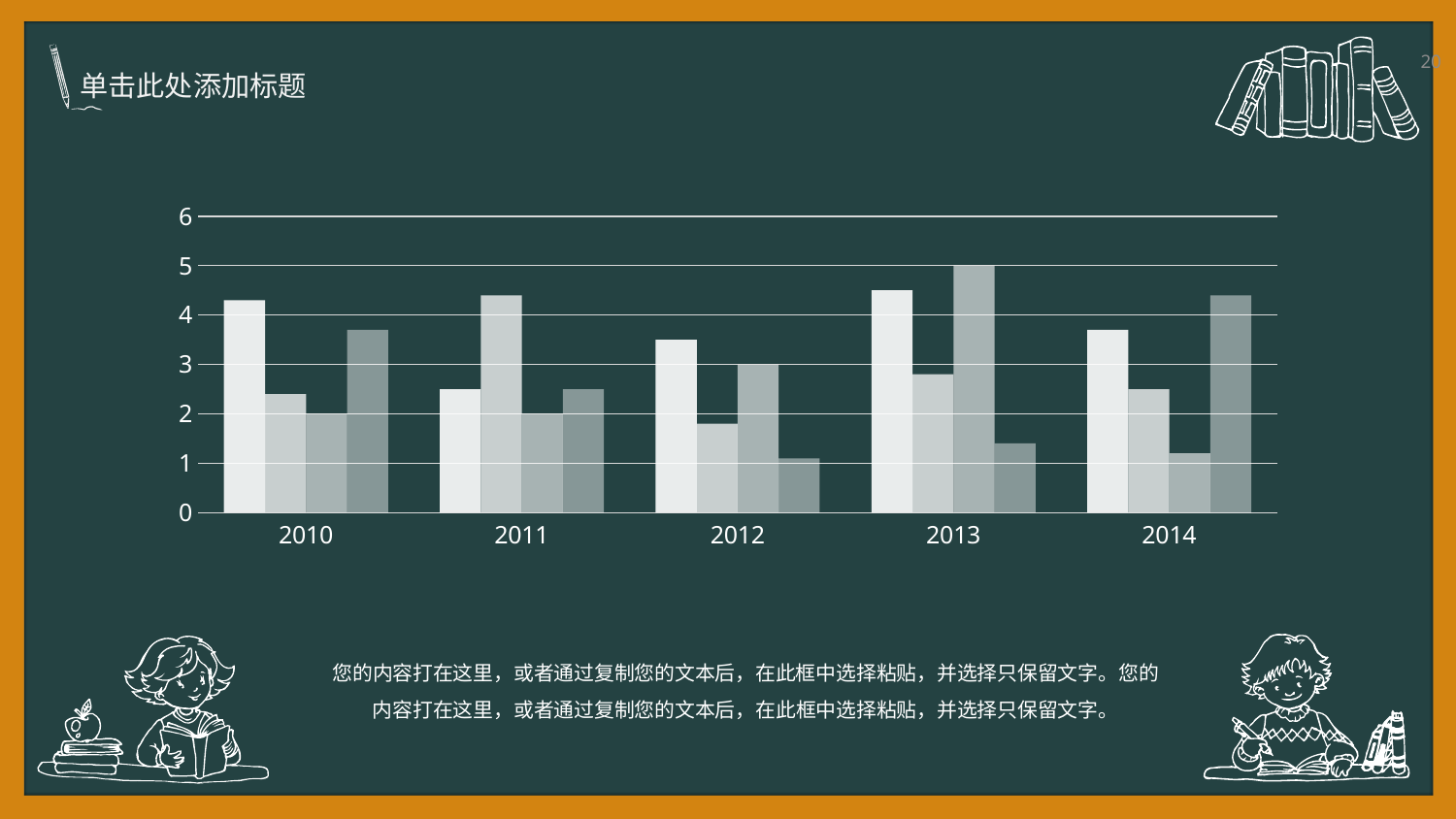
How many year categories are shown on the x axis? 5 Is the value of the fourth bar in the 2013 group greater or less than 2? less What is the highest value shown on the y axis? 6 What is the first year label on the x axis? 2010 Which year group contains the tallest bar on the chart? 2013 Is the value of the first bar in the 2010 group greater or less than 3? greater Is the value of the fourth bar in the 2012 group greater or less than 2? less What kind of chart is shown on the slide? bar chart How many bars are there in each year group? 4 Which is larger: the first bar in the 2010 group or the first bar in the 2011 group? the first bar in the 2010 group What value does the tallest bar in the 2013 group reach? 5